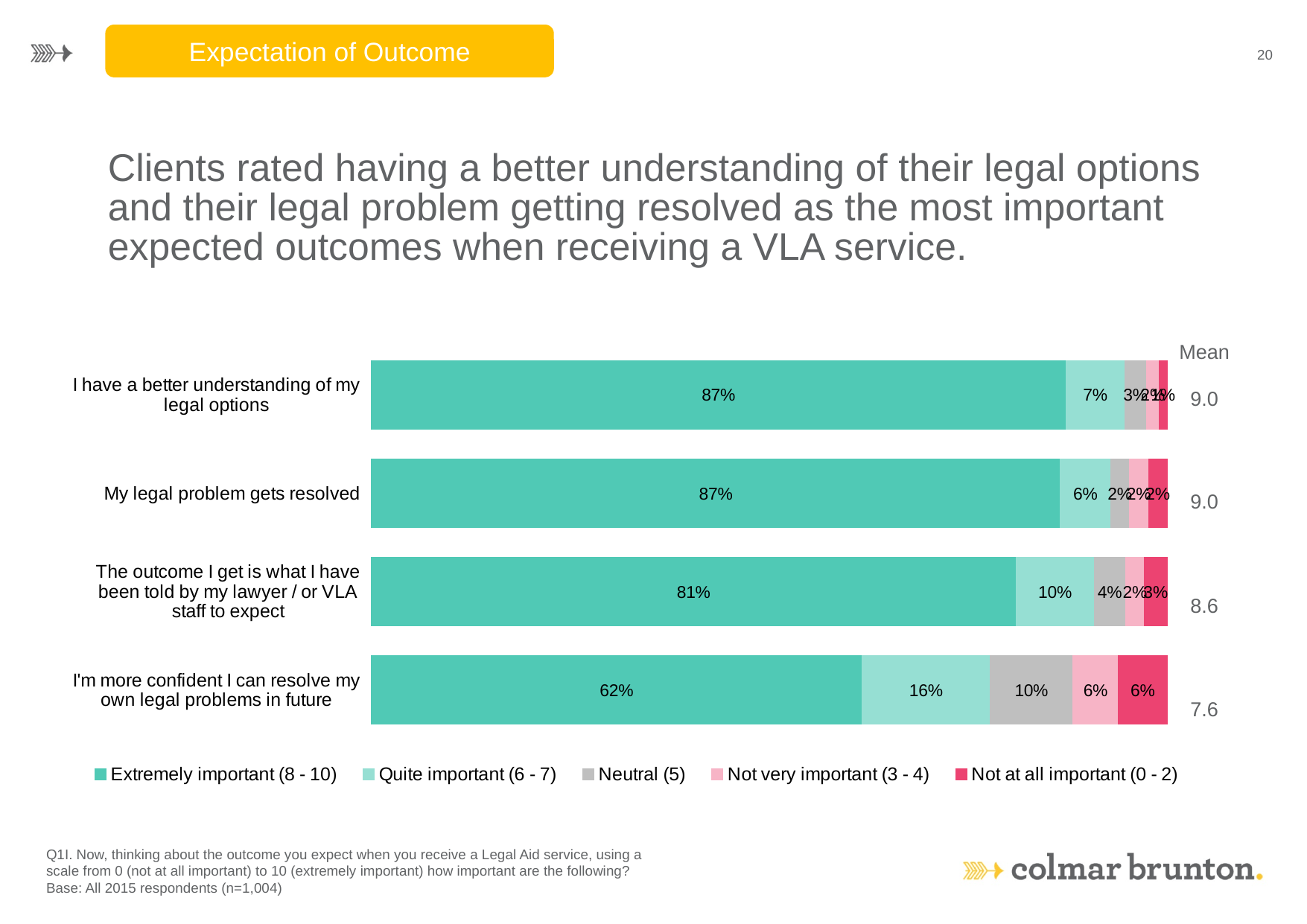
What kind of chart is shown on the slide? Stacked bar chart Which outcome statement has the lowest mean score? I'm more confident I can resolve my own legal problems in future What is the mean score for 'I have a better understanding of my legal options'? 9.0 Which has a larger Extremely important (8 - 10) share: 'The outcome I get is what I have been told by my lawyer / or VLA staff to expect' or 'I'm more confident I can resolve my own legal problems in future'? The outcome I get is what I have been told by my lawyer / or VLA staff to expect How many series does the legend list? 5 How many outcome statements (categories) are plotted in the chart? 4 What is the difference between the Extremely important (8 - 10) percentages for 'My legal problem gets resolved' and 'I'm more confident I can resolve my own legal problems in future'? 25% What is the mean score for 'The outcome I get is what I have been told by my lawyer / or VLA staff to expect'? 8.6 What percentage of clients rated 'I'm more confident I can resolve my own legal problems in future' as Extremely important (8 - 10)? 62% What is the Not at all important (0 - 2) percentage for 'I'm more confident I can resolve my own legal problems in future'? 6% What is the Neutral (5) percentage for 'I'm more confident I can resolve my own legal problems in future'? 10% What percentage rated 'The outcome I get is what I have been told by my lawyer / or VLA staff to expect' as Quite important (6 - 7)? 10%